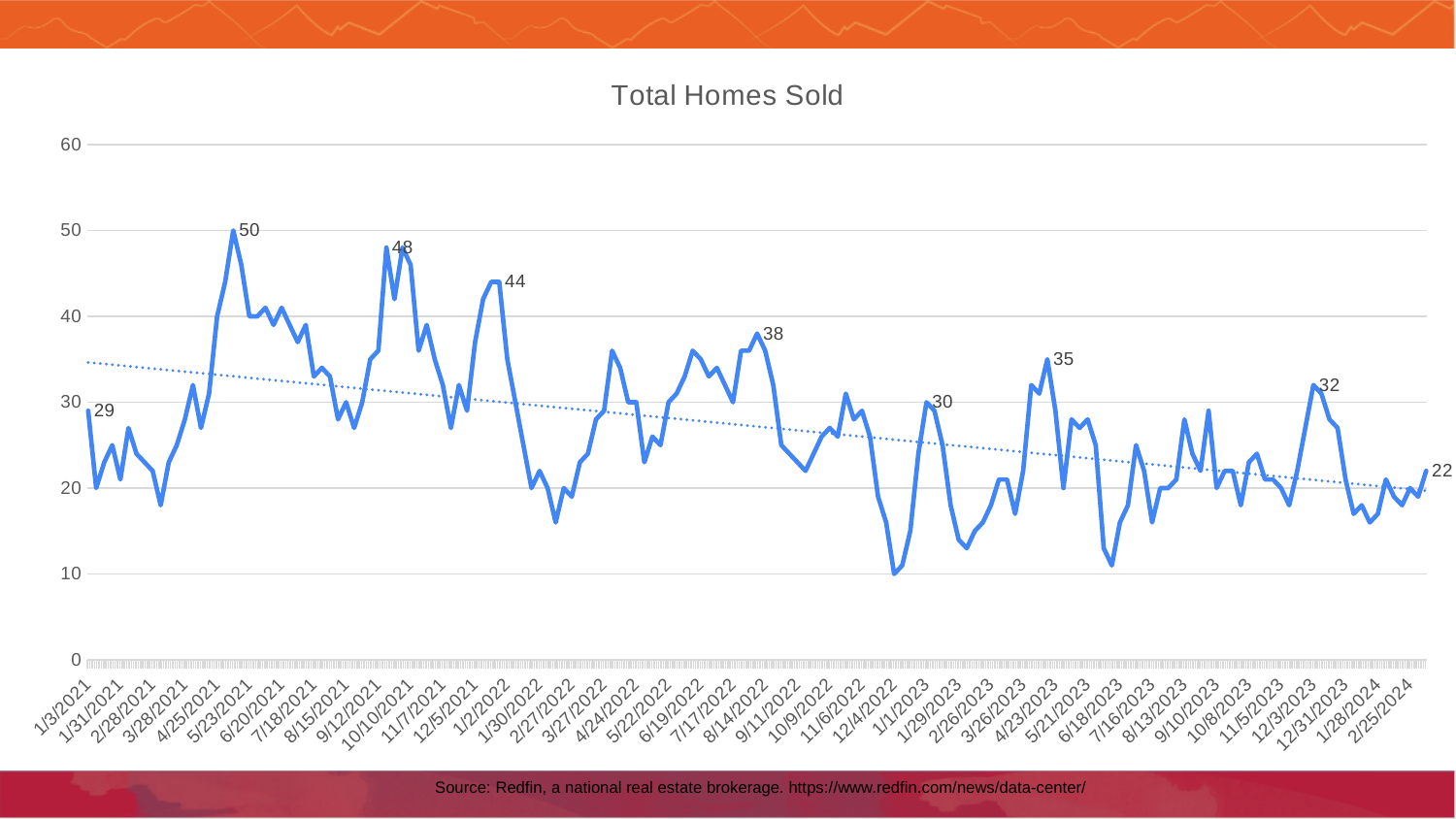
Which labeled value is larger, 48 or 44? 48 Does the dotted trend line rise or fall from left to right? falls What is the value of the last labeled point on the line, at the right end of the chart? 22 Is the lowest point on the line greater or less than 20? less What is the difference between the labeled values 38 and 30? 8 What kind of chart is shown on the slide? line chart What is the title of the chart? Total Homes Sold What is the value of the first labeled point on the line, at 1/3/2021? 29 What is the difference between the highest labeled value (50) and the last labeled value (22)? 28 How many data labels are printed on the line? 9 What is the lowest labeled value on the line? 22 What is the highest labeled value on the line? 50